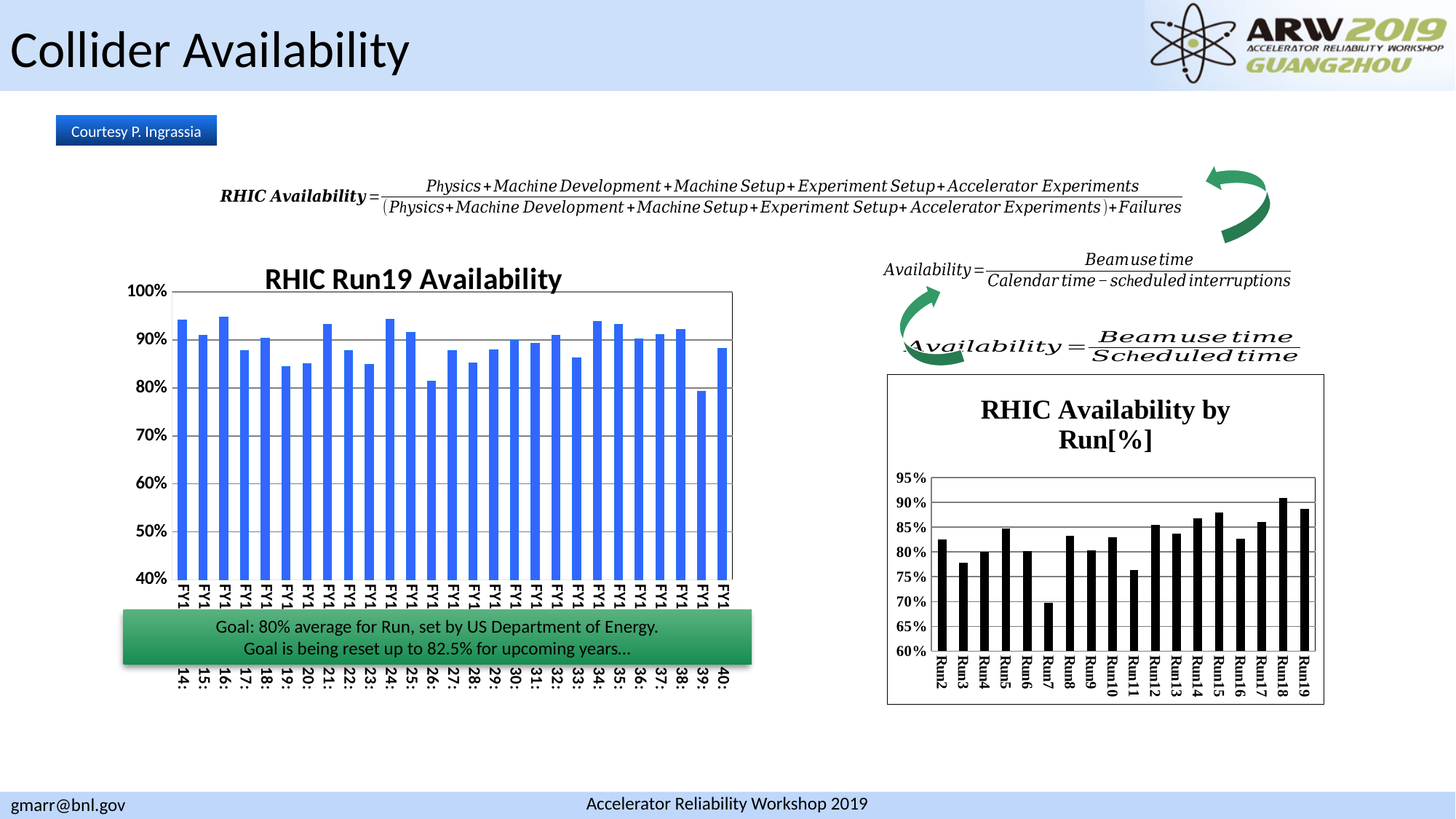
In the 'RHIC Run19 Availability' chart, is the lowest bar (the second-to-last bar) greater or less than 80%? less What colour are the bars in the 'RHIC Run19 Availability' chart? blue What kind of chart is the 'RHIC Availability by Run[%]' chart? bar chart In the 'RHIC Availability by Run[%]' chart, is the value for Run7 greater or less than 75%? less In the 'RHIC Availability by Run[%]' chart, which is larger, the value for Run3 or the value for Run5? Run5 What kind of chart is the 'RHIC Run19 Availability' chart? bar chart How many runs are plotted in the 'RHIC Availability by Run[%]' chart? 18 In the 'RHIC Availability by Run[%]' chart, which run has the lowest availability? Run7 In the 'RHIC Availability by Run[%]' chart, is the value for Run11 greater or less than 80%? less In the 'RHIC Availability by Run[%]' chart, which is larger, the value for Run15 or the value for Run16? Run15 In the 'RHIC Availability by Run[%]' chart, which run has the highest availability? Run18